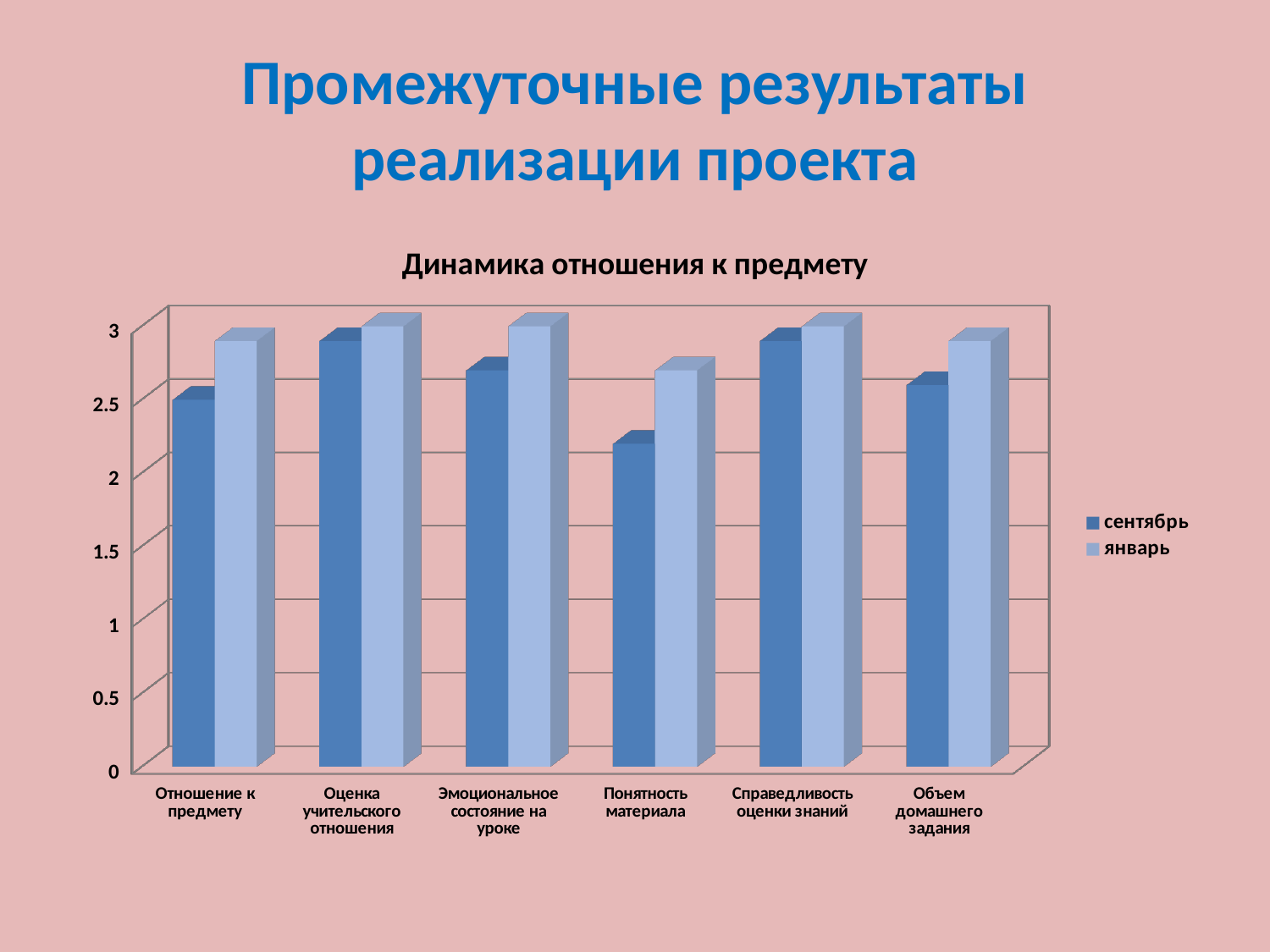
For сентябрь, which is larger: the value for Отношение к предмету or the value for Понятность материала? Отношение к предмету Which category has the lowest value for сентябрь? Понятность материала How many categories are shown on the x axis of the chart? 6 Which category has the lowest value for январь? Понятность материала Is the январь value for Понятность материала greater or less than 2.5? greater For Понятность материала, which is larger: the сентябрь value or the январь value? январь What is the title of the chart? Динамика отношения к предмету Is the сентябрь value for Справедливость оценки знаний greater or less than 2.5? greater How many series does the legend list? 2 Which series are listed in the legend? сентябрь, январь Is the сентябрь value for Понятность материала greater or less than 2.5? less What kind of chart is shown on the slide? bar chart